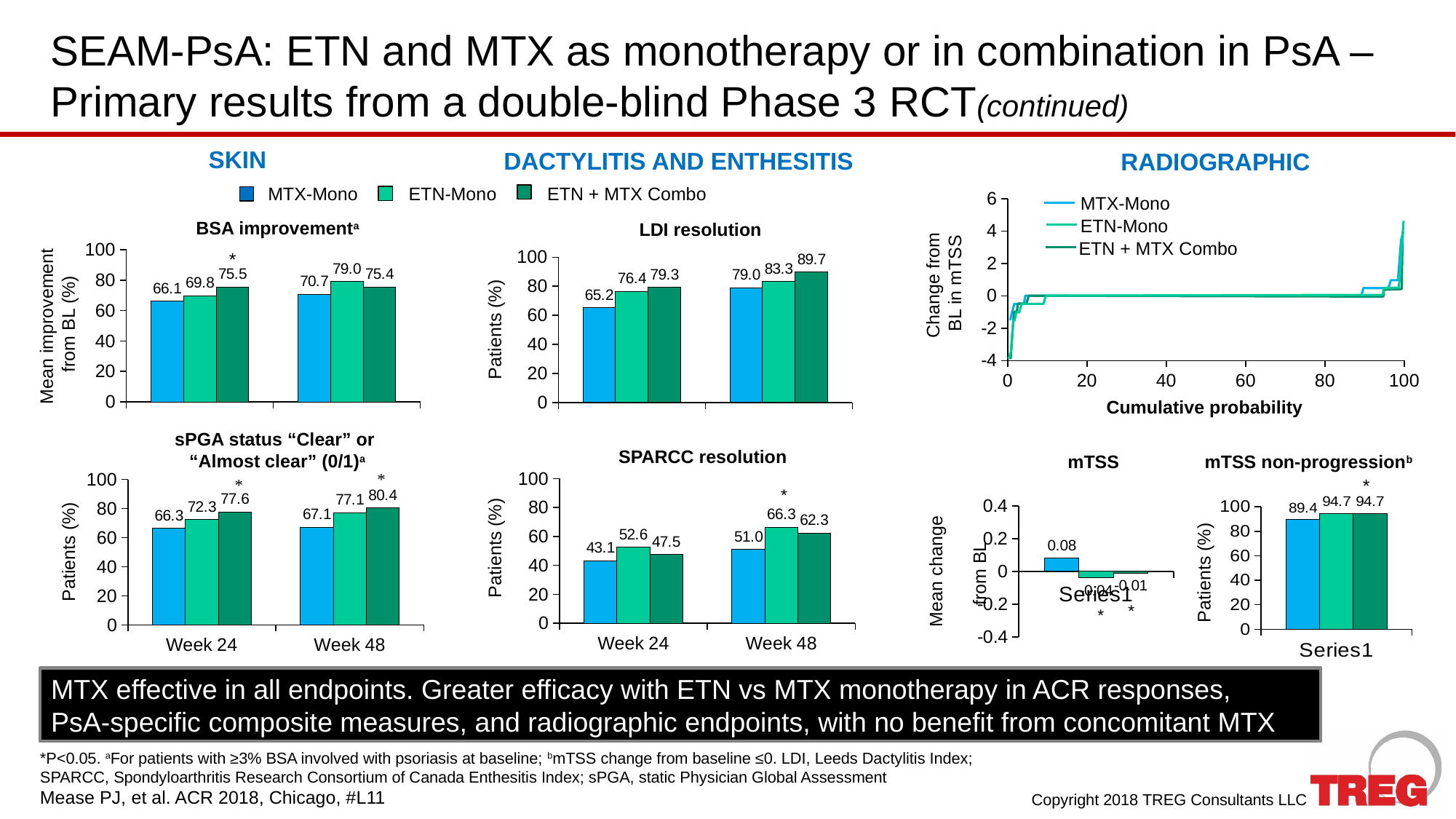
In the LDI resolution chart, does the MTX-Mono value rise or fall from Week 24 to Week 48? rise In the BSA improvement chart, what is the value for ETN + MTX Combo at Week 24? 75.5 In the SPARCC resolution chart, which treatment group has the highest value at Week 48? ETN-Mono In the SPARCC resolution chart, which treatment group has the lowest value at Week 24? MTX-Mono In the SPARCC resolution chart, how many time points are shown on the x axis? 2 What is the x-axis title of the line chart under the RADIOGRAPHIC heading? Cumulative probability In the BSA improvement chart at Week 48, which is larger: ETN-Mono or ETN + MTX Combo? ETN-Mono How many series does the legend above the SKIN and DACTYLITIS AND ENTHESITIS charts list? 3 What kind of chart is the LDI resolution chart? bar chart In the mTSS non-progression chart, what is the value for MTX-Mono? 89.4 In the sPGA status "Clear" or "Almost clear" chart, what is the difference between ETN + MTX Combo and MTX-Mono at Week 48? 13.3 In the LDI resolution chart, what is the value for ETN-Mono at Week 48? 83.3